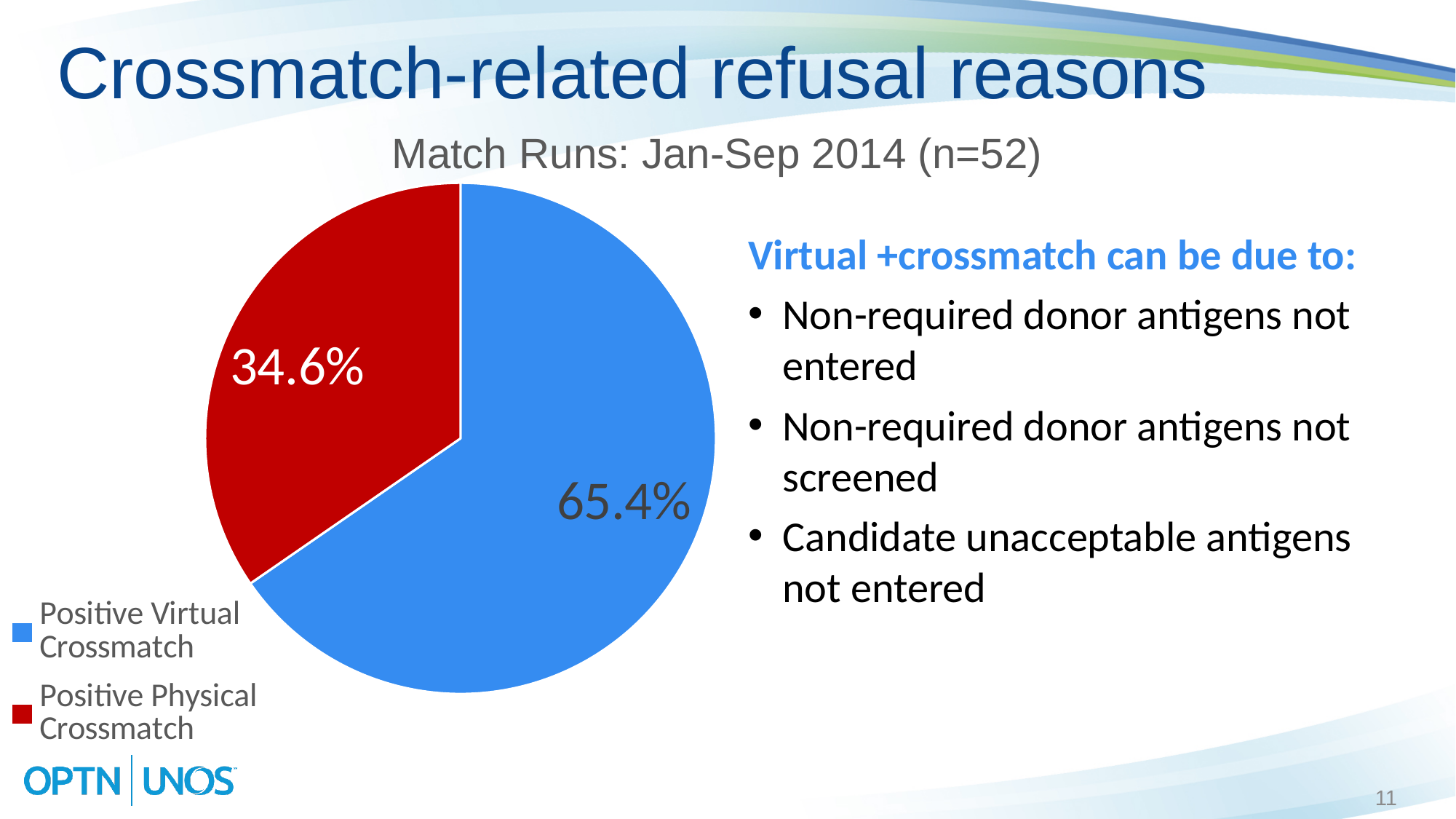
How many slices does the pie chart have? 2 What kind of chart is shown on the slide? pie chart Which slice of the pie is the largest? Positive Virtual Crossmatch What is the subtitle above the pie chart? Match Runs: Jan-Sep 2014 (n=52) What share of the pie is Positive Physical Crossmatch? 34.6% What is the difference in percentage points between the Positive Virtual Crossmatch and Positive Physical Crossmatch slices? 30.8 Which is larger, the Positive Virtual Crossmatch slice or the Positive Physical Crossmatch slice? Positive Virtual Crossmatch What share of the pie is Positive Virtual Crossmatch? 65.4% What colour is the Positive Physical Crossmatch slice? red How many entries does the legend list? 2 Which slice of the pie is the smallest? Positive Physical Crossmatch